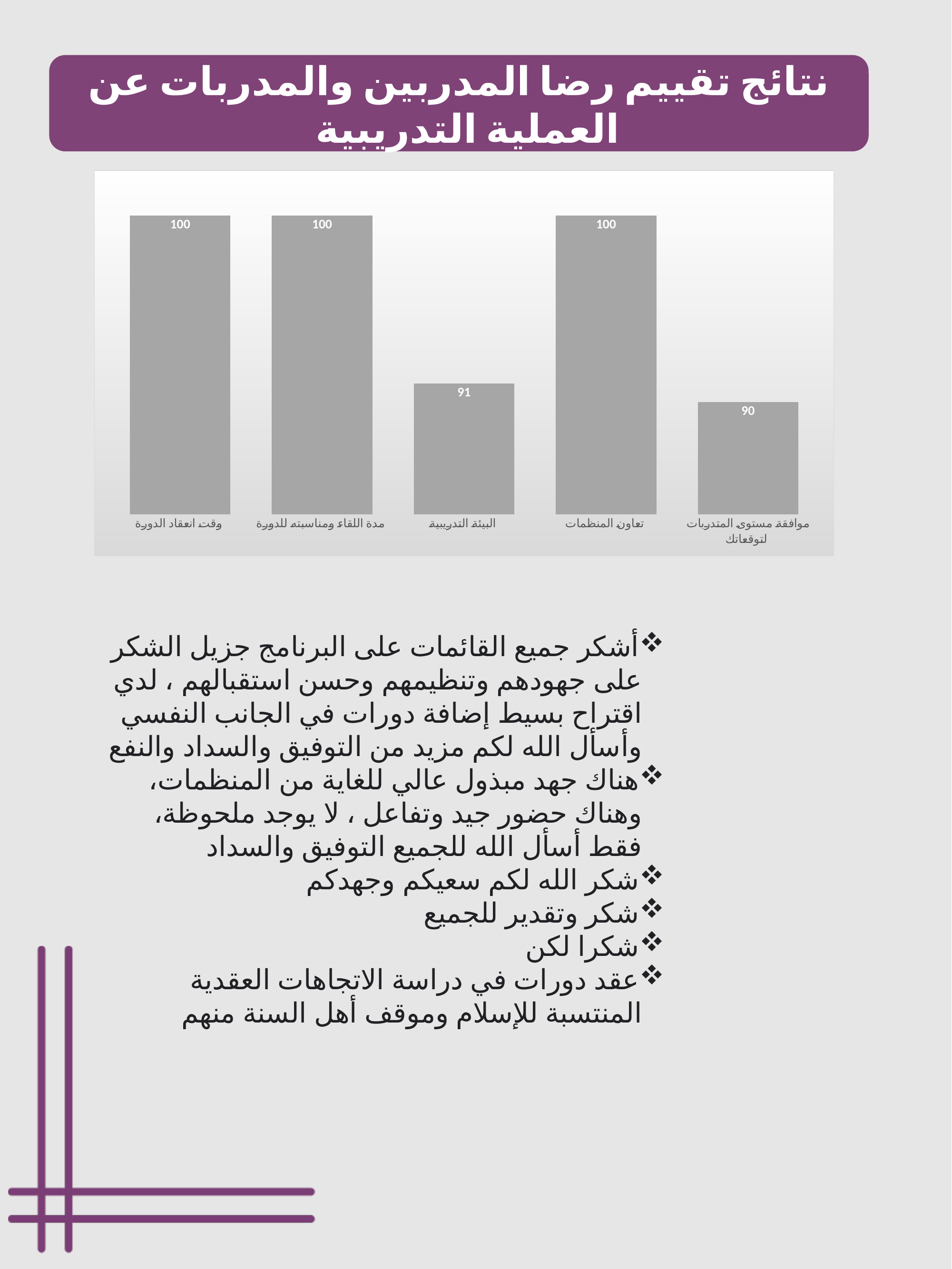
What is the difference between the values for تعاون المنظمات and البيئة التدريبية? 9 Which category has the lowest value? موافقة مستوى المتدربات لتوقعاتك How many categories are shown in the chart? 5 Which is larger, the value for مدة اللقاء ومناسبته للدورة or the value for البيئة التدريبية? مدة اللقاء ومناسبته للدورة How many categories have a value of 100? 3 What colour are the bars in the chart? grey What is the value for البيئة التدريبية? 91 What is the value for موافقة مستوى المتدربات لتوقعاتك? 90 What is the value for تعاون المنظمات? 100 What is the difference between the values for البيئة التدريبية and موافقة مستوى المتدربات لتوقعاتك? 1 What is the value for وقت انعقاد الدورة? 100 What kind of chart is shown on the slide? bar chart